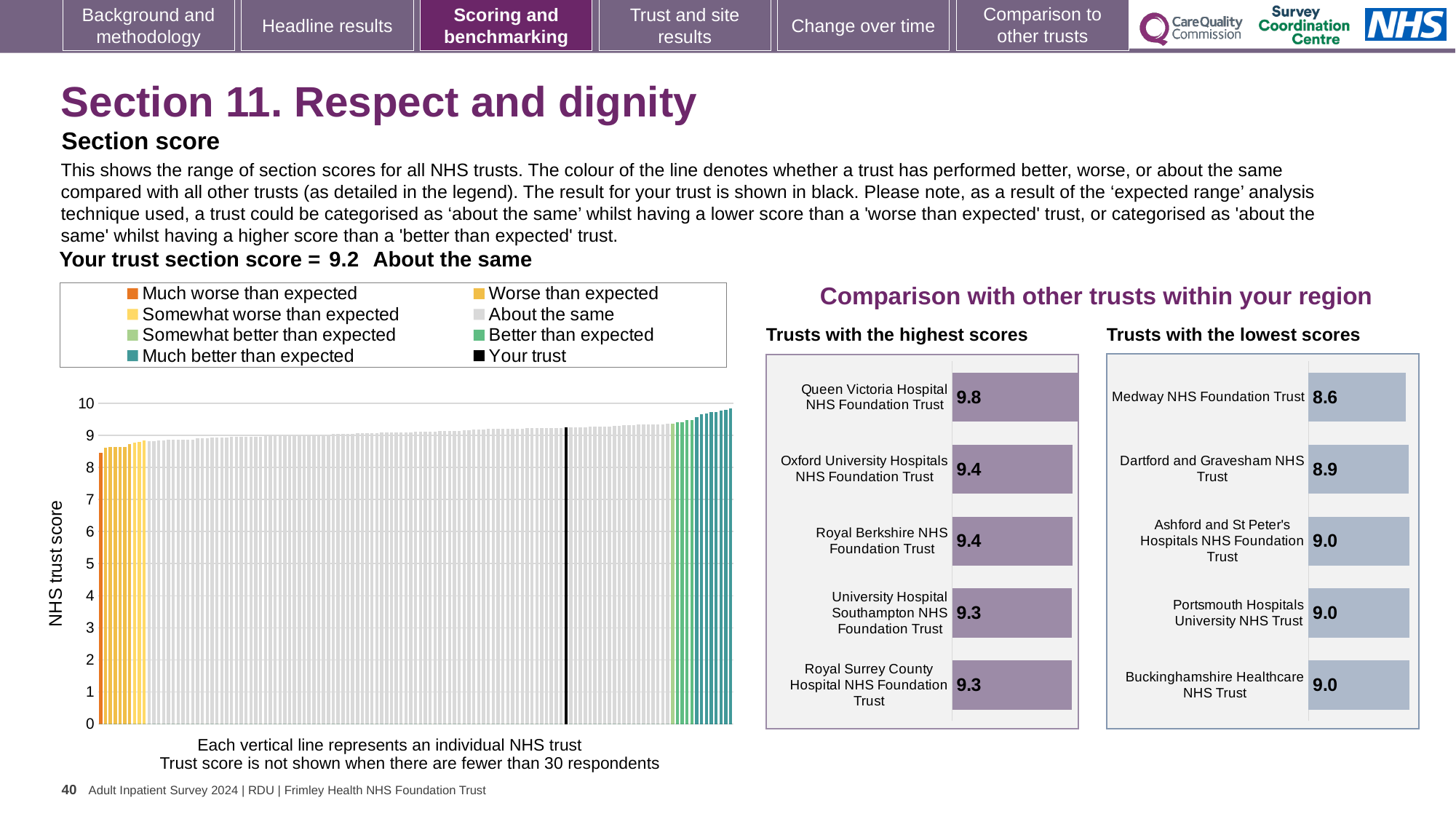
In the 'Trusts with the lowest scores' chart, which trust has the lowest score? Medway NHS Foundation Trust In the 'Trusts with the highest scores' chart, what is the score for University Hospital Southampton NHS Foundation Trust? 9.3 In the large chart on the left showing NHS trust scores, is the value for the black 'Your trust' line greater or less than 9? greater In the 'Trusts with the lowest scores' chart, which has the larger score: Medway NHS Foundation Trust or Dartford and Gravesham NHS Trust? Dartford and Gravesham NHS Trust In the large chart on the left showing NHS trust scores, do the values rise or fall from left to right along the x axis? rise In the 'Trusts with the highest scores' chart, which trust has the highest score? Queen Victoria Hospital NHS Foundation Trust In the 'Trusts with the highest scores' chart, what is the difference between the scores of Queen Victoria Hospital NHS Foundation Trust and Royal Surrey County Hospital NHS Foundation Trust? 0.5 How many entries does the legend of the large chart on the left list? 8 In the 'Trusts with the lowest scores' chart, what is the score for Medway NHS Foundation Trust? 8.6 In the 'Trusts with the lowest scores' chart, what is the score for Dartford and Gravesham NHS Trust? 8.9 In the 'Trusts with the highest scores' chart, what is the score for Queen Victoria Hospital NHS Foundation Trust? 9.8 How many trusts are shown in the 'Trusts with the lowest scores' chart? 5